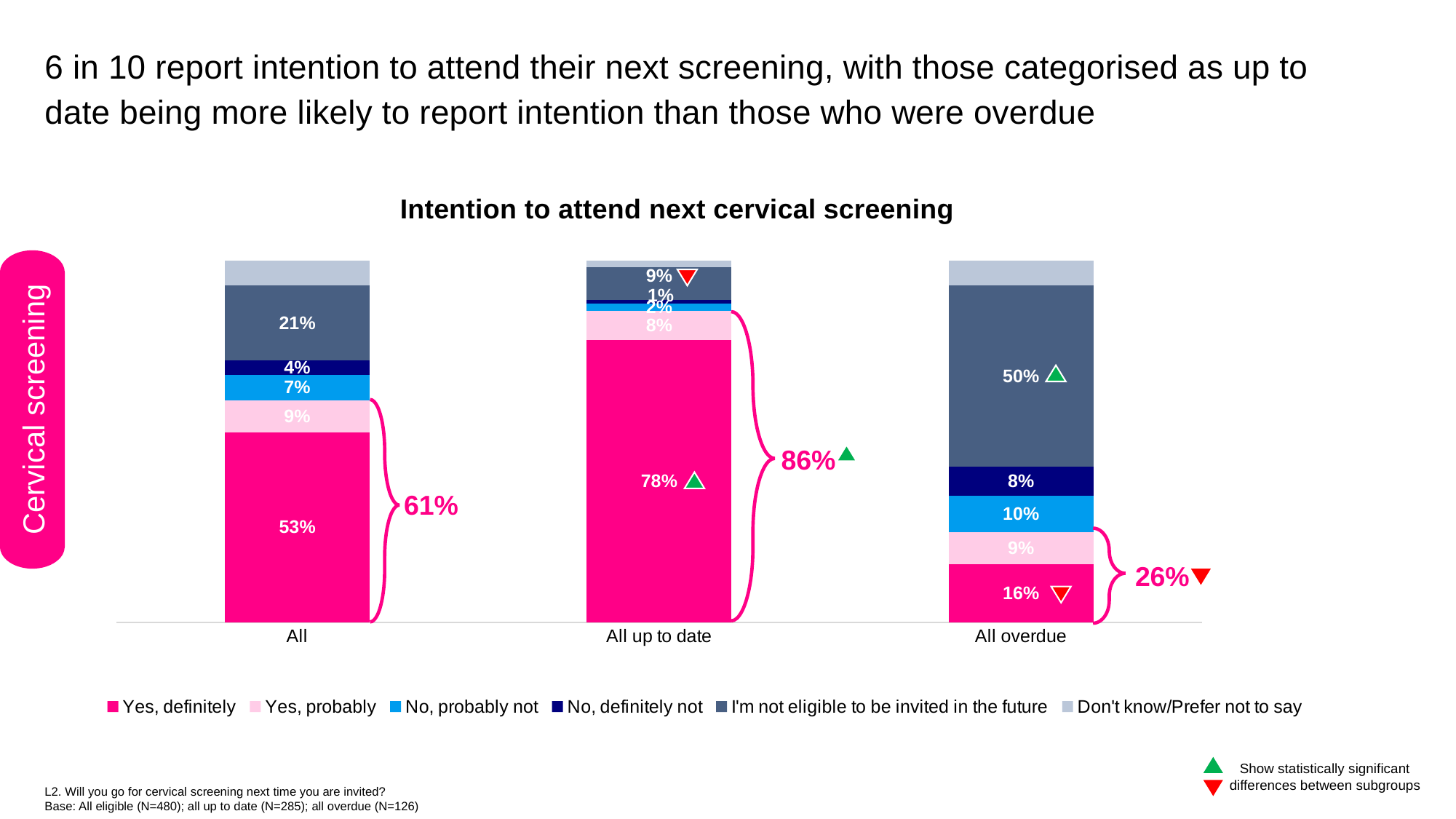
What percentage of the 'All overdue' group said 'I'm not eligible to be invited in the future'? 50% How many groups (bars) are shown on the x axis? 3 What percentage of the 'All' group answered 'Yes, definitely'? 53% How many series does the legend list? 6 Which is larger: the 'No, probably not' share for 'All' or for 'All overdue'? All overdue Which group has the highest 'Yes, definitely' percentage? All up to date Which group has the lowest 'Yes, definitely' percentage? All overdue What is the difference in 'Yes, definitely' percentage between 'All up to date' and 'All overdue'? 62 percentage points What percentage of the 'All up to date' group answered 'Yes, definitely'? 78% What is the combined 'Yes' percentage shown by the bracket for the 'All up to date' group? 86% What is the combined 'Yes' (definitely or probably) percentage shown by the bracket for the 'All overdue' group? 26% What kind of chart is shown on the slide? Stacked bar chart